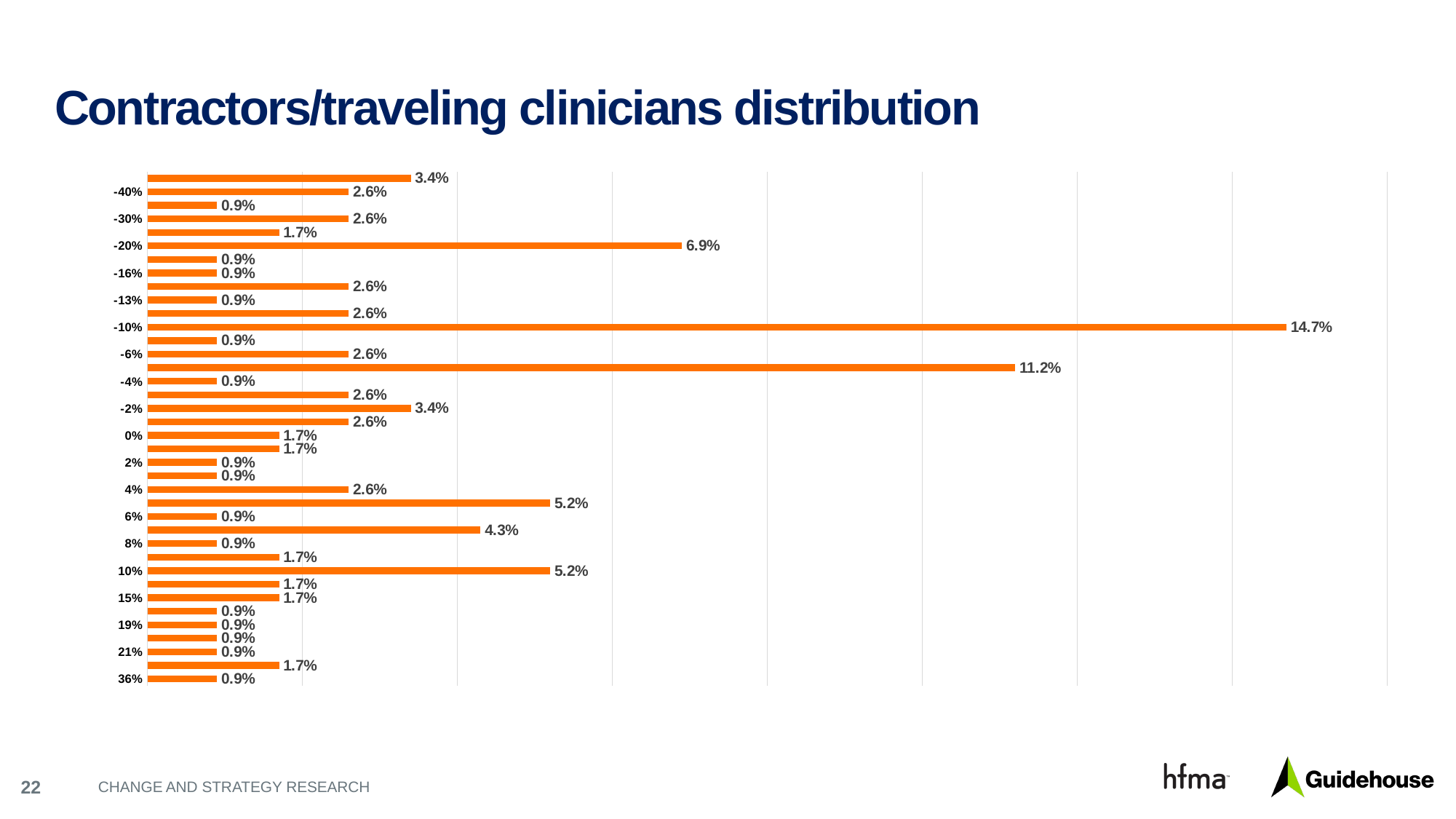
How many bars are plotted in the chart? 38 Which labeled category has the highest value? -10% What is the value for the -40% category? 2.6% What type of chart is shown on the slide? Bar chart What is the value for the 10% category? 5.2% Which has a larger value, the -20% category or the -2% category? -20% What is the title of the chart? Contractors/traveling clinicians distribution What is the difference between the values for the -10% and -20% categories? 7.8% What is the value for the -20% category? 6.9% What is the value for the 0% category? 1.7% What is the value for the 36% category? 0.9% What is the value for the -10% category? 14.7%